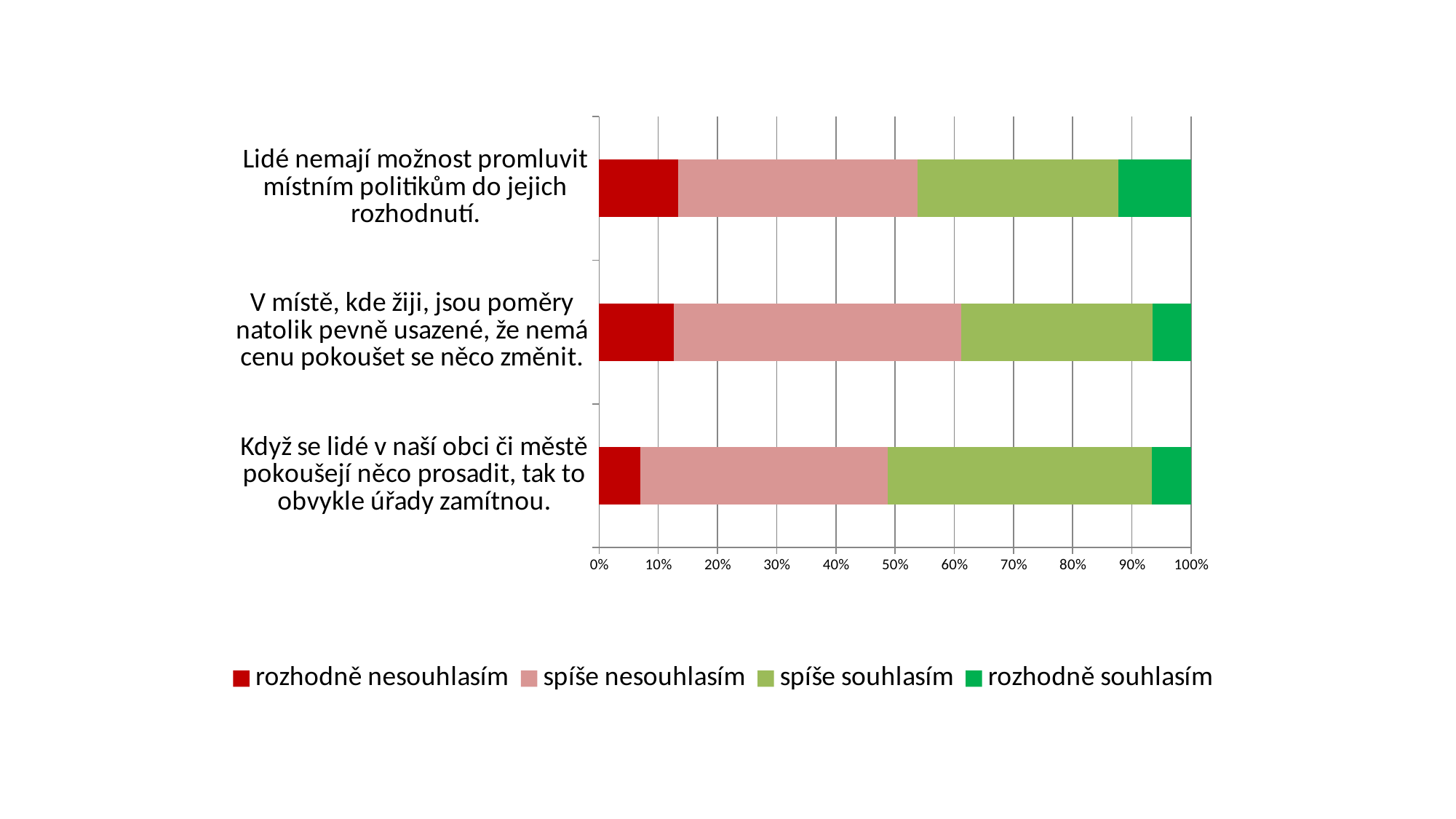
How many statements (categories) are plotted on the chart? 3 Is the "rozhodně souhlasím" share for "V místě, kde žiji, jsou poměry natolik pevně usazené, že nemá cenu pokoušet se něco změnit." greater or less than 10%? less Which has the larger "spíše souhlasím" share: "Lidé nemají možnost promluvit místním politikům do jejich rozhodnutí." or "Když se lidé v naší obci či městě pokoušejí něco prosadit, tak to obvykle úřady zamítnou."? Když se lidé v naší obci či městě pokoušejí něco prosadit, tak to obvykle úřady zamítnou. How many series does the legend list? 4 Is the "rozhodně nesouhlasím" share for "Lidé nemají možnost promluvit místním politikům do jejich rozhodnutí." greater or less than 10%? greater Which statement has the largest "rozhodně souhlasím" share? Lidé nemají možnost promluvit místním politikům do jejich rozhodnutí. Is the "rozhodně nesouhlasím" share for "Když se lidé v naší obci či městě pokoušejí něco prosadit, tak to obvykle úřady zamítnou." greater or less than 10%? less Which colour represents the series "rozhodně souhlasím"? dark green Which statement has the largest "spíše souhlasím" share? Když se lidé v naší obci či městě pokoušejí něco prosadit, tak to obvykle úřady zamítnou. What kind of chart is shown on the slide? stacked bar chart Which statement has the smallest "rozhodně nesouhlasím" share? Když se lidé v naší obci či městě pokoušejí něco prosadit, tak to obvykle úřady zamítnou. What are the four series listed in the legend? rozhodně nesouhlasím, spíše nesouhlasím, spíše souhlasím, rozhodně souhlasím